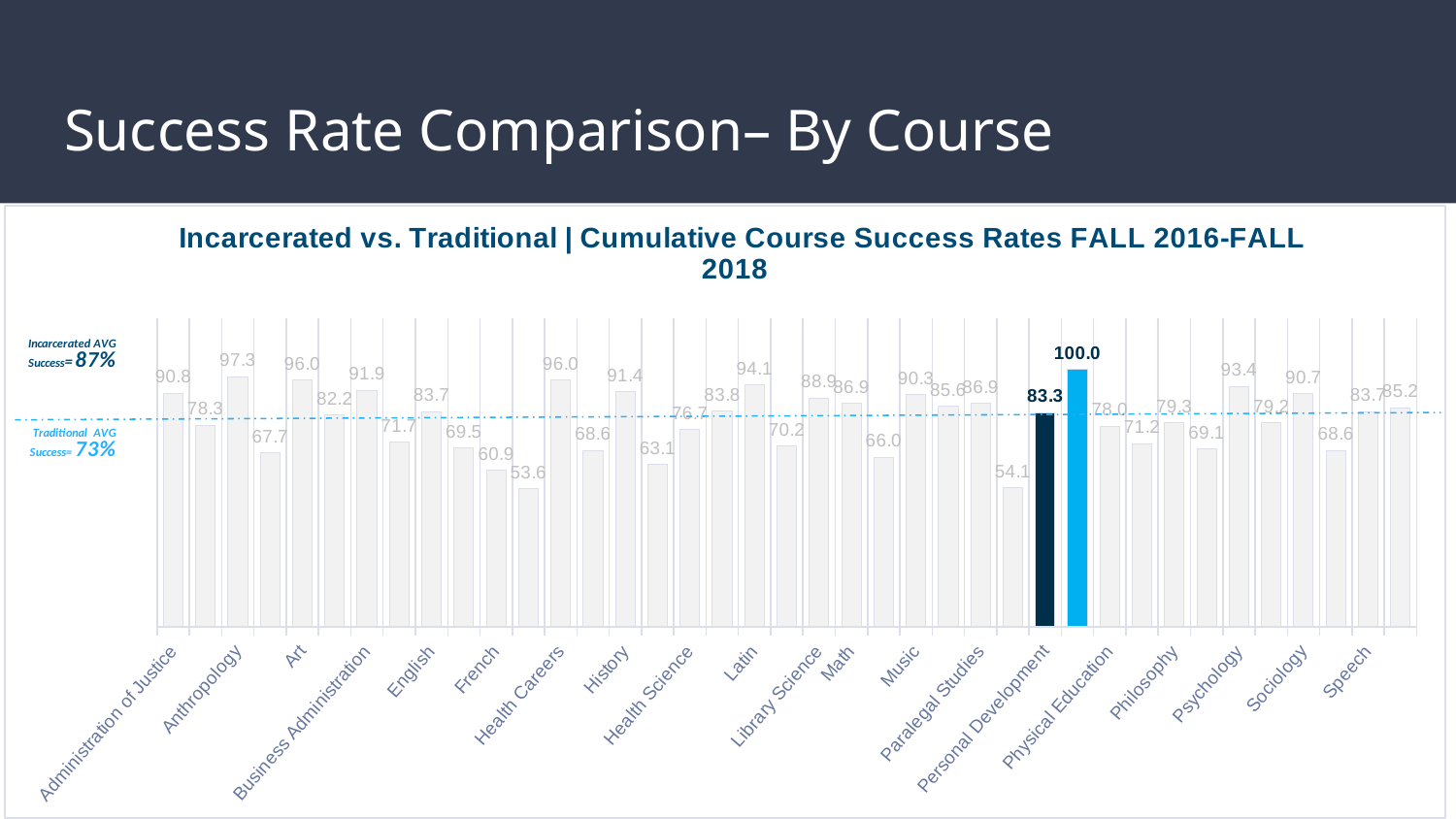
What type of chart is shown on the slide? bar chart What is the title of the chart? Incarcerated vs. Traditional | Cumulative Course Success Rates FALL 2016-FALL 2018 Which of the two highlighted Personal Development bars is larger, the light blue one or the dark navy one? the light blue one What is the Traditional average success rate shown on the chart? 73% What is the highest value labelled on the chart? 100.0 Which course has the bar reaching 100.0? Personal Development What is the difference between the two highlighted Personal Development bars (100.0 and 83.3)? 16.7 What is the value of the dark navy highlighted bar for Personal Development? 83.3 How many courses are listed along the x axis of the chart? 20 What is the value of the light blue highlighted bar for Personal Development? 100.0 What is the lowest value labelled on the chart? 53.6 What is the Incarcerated average success rate shown on the chart? 87%